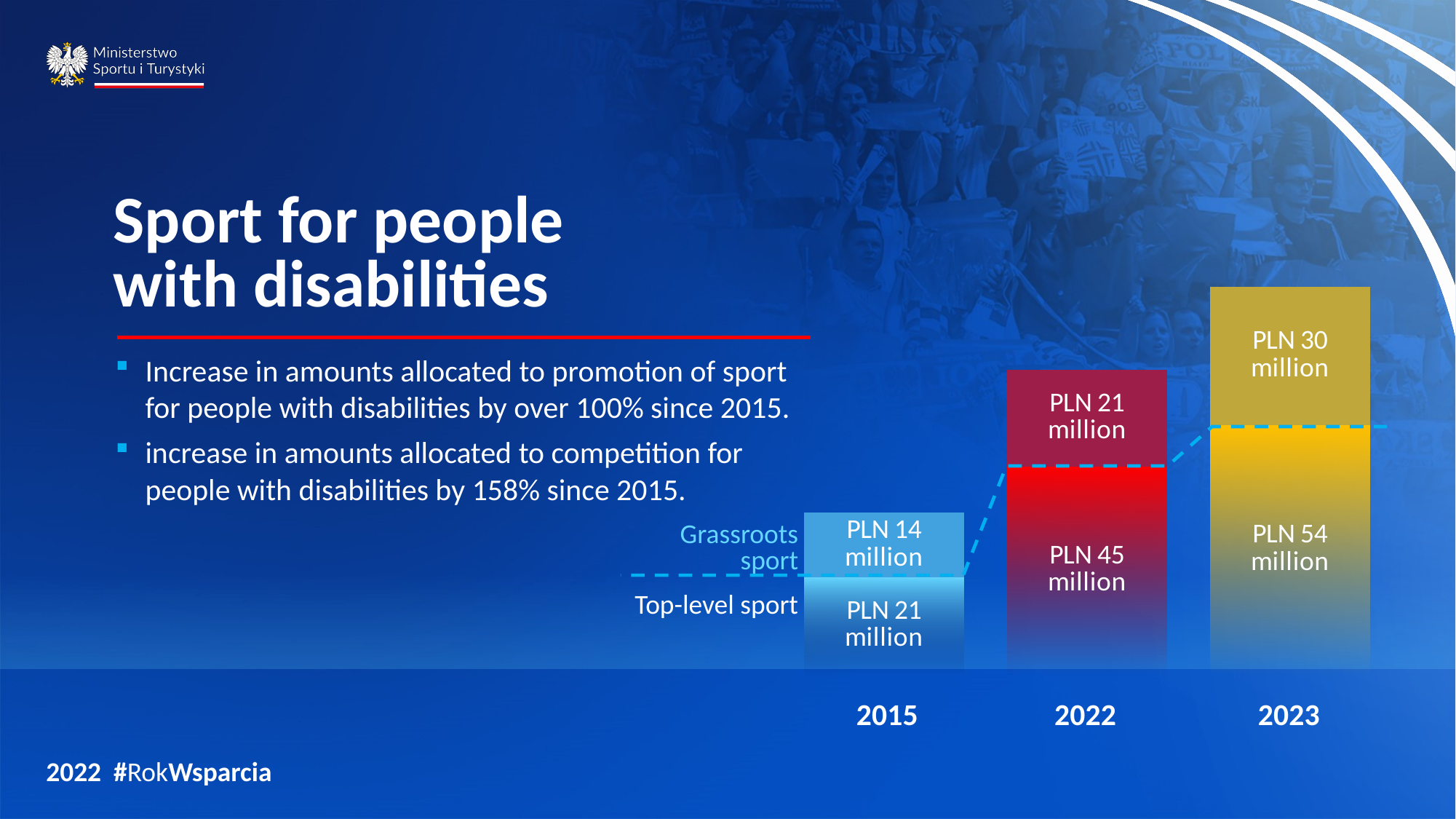
What amount was allocated to grassroots sport in 2023? PLN 30 million Which year has the lowest amount for grassroots sport? 2015 What is the total amount (grassroots plus top-level sport) for 2015? PLN 35 million What is the difference between the top-level sport amounts in 2023 and 2015? PLN 33 million What amount was allocated to top-level sport in 2015? PLN 21 million What kind of chart is shown on the slide? Stacked bar chart Which year has the highest amount for top-level sport? 2023 What is the total amount (grassroots plus top-level sport) for 2023? PLN 84 million What amount was allocated to grassroots sport in 2015? PLN 14 million Which is larger: the grassroots sport amount in 2022 or the top-level sport amount in 2015? They are equal (PLN 21 million) How many years are shown on the chart? 3 What amount was allocated to top-level sport in 2022? PLN 45 million